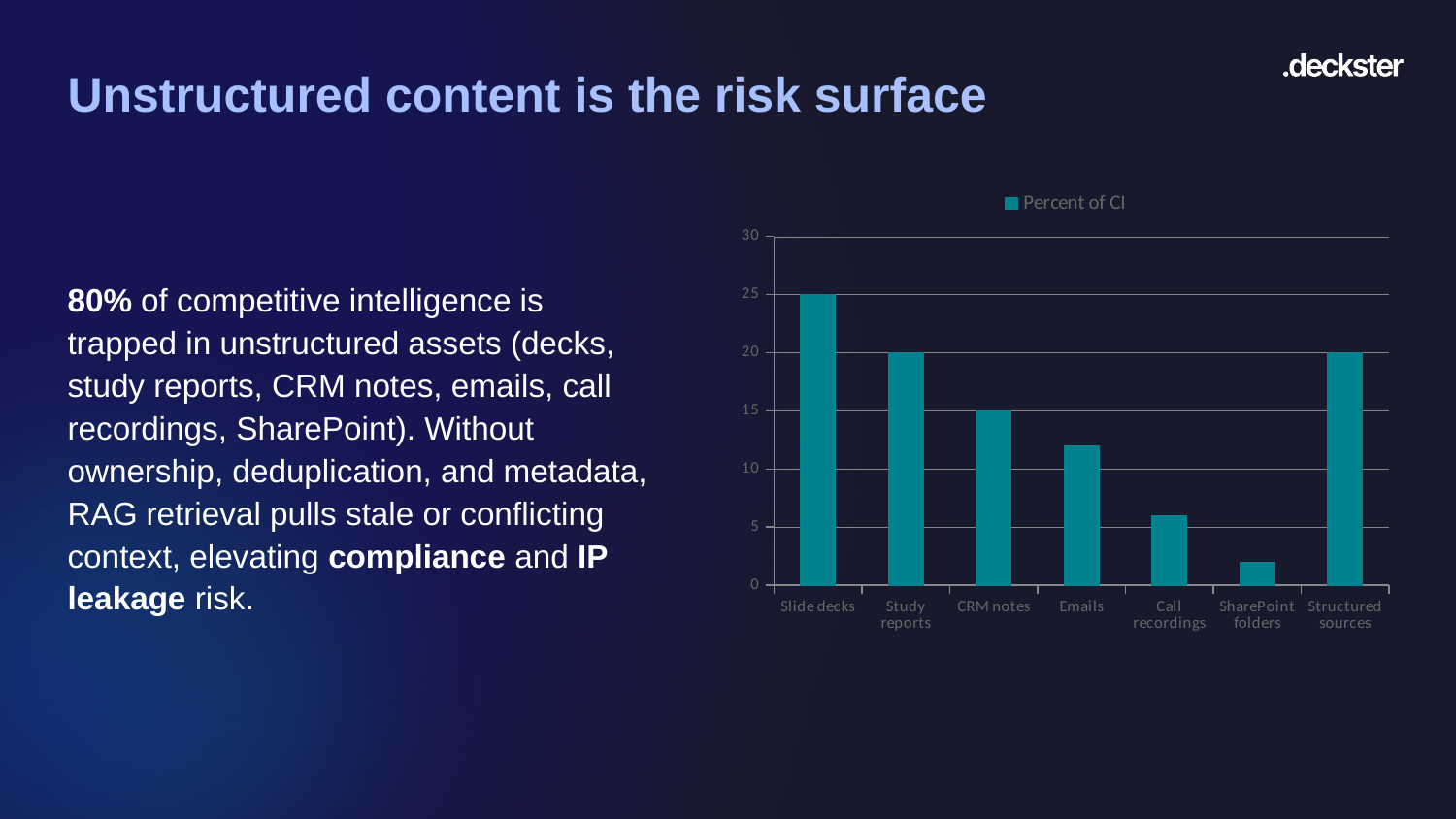
What is the difference between the values for Slide decks and CRM notes? 10 How many categories are shown on the x axis of the chart? 7 Which category has the lowest value in the chart? SharePoint folders How many series does the chart legend list? 1 What is the value for CRM notes? 15 What is the value for Structured sources? 20 Which category has the highest value in the chart? Slide decks Which is larger, the value for Emails or the value for Call recordings? Emails What is the name of the series shown in the chart legend? Percent of CI Is the value for Emails greater or less than 10? greater What is the value for Slide decks? 25 What type of chart is shown on the slide? bar chart